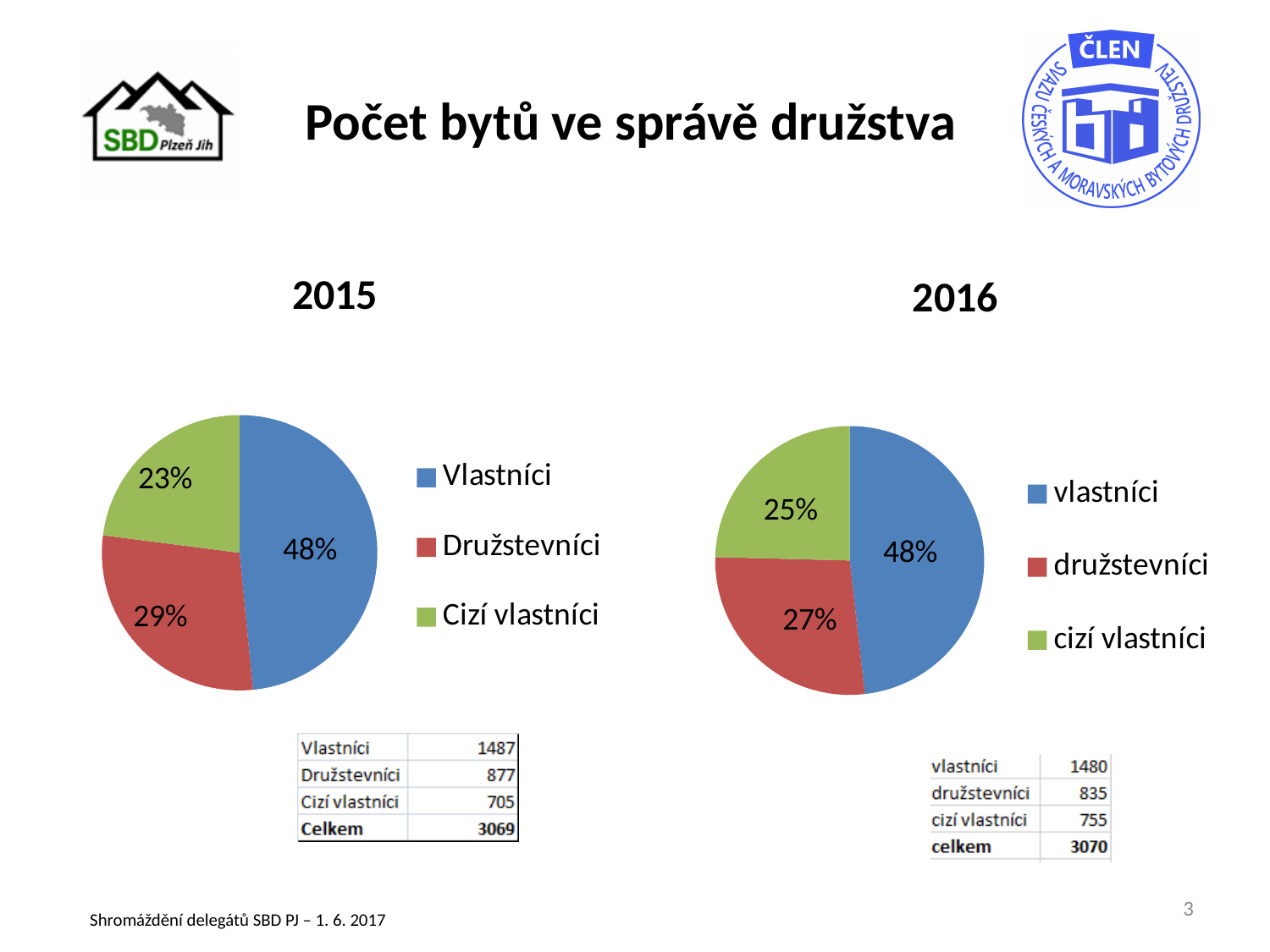
In the 2015 pie chart, what is the difference in percentage points between Družstevníci and Cizí vlastníci? 6 percentage points In the 2016 pie chart, what colour is the cizí vlastníci slice? Green How many slices does the 2015 pie chart have? 3 In the 2015 pie chart, which category has the smallest slice? Cizí vlastníci In the 2016 pie chart, what share is shown for družstevníci? 27% In the 2016 pie chart, what share is shown for cizí vlastníci? 25% In the 2015 pie chart, what share is shown for Cizí vlastníci? 23% In the 2016 pie chart, which category has the largest slice? vlastníci In the 2015 pie chart, what share is shown for Vlastníci? 48% What type of chart is used for the 2016 data? Pie chart In the 2016 pie chart, which slice is larger: družstevníci or cizí vlastníci? družstevníci In the 2015 pie chart, what share is shown for Družstevníci? 29%